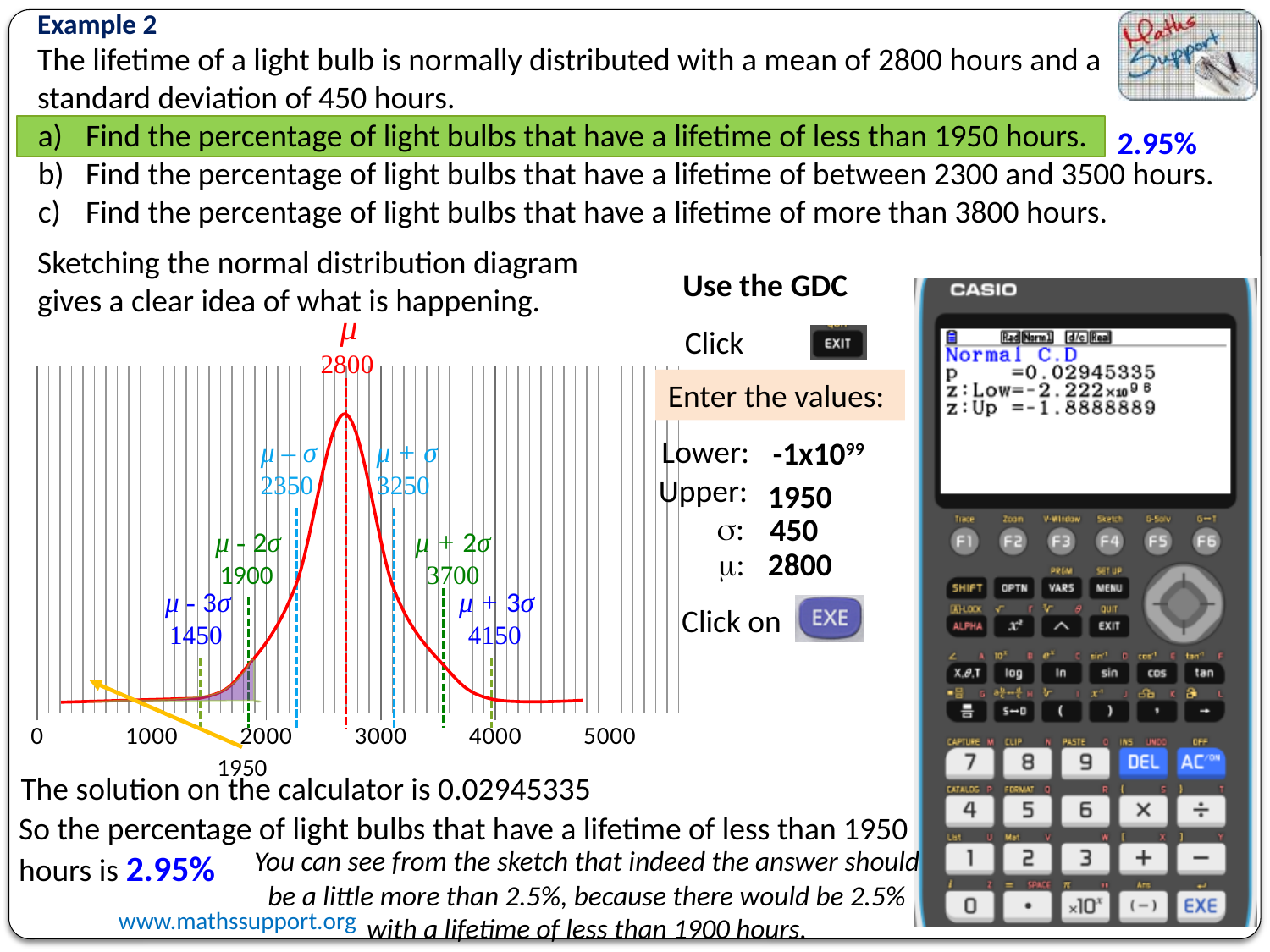
What value is labelled at μ − 2σ on the normal distribution sketch? 1900 What is the difference between the values labelled at μ + σ and μ − σ on the sketch? 900 What is the largest value printed on the x axis of the normal distribution sketch? 5000 What kind of chart is the normal distribution sketch? Line chart (bell curve) What colour is the normal distribution curve drawn in? Red What value is labelled at the mean μ on the normal distribution sketch? 2800 What value is labelled at μ − 3σ on the normal distribution sketch? 1450 What value is labelled at μ + 2σ on the normal distribution sketch? 3700 What value marks the right edge of the shaded region under the curve? 1950 What value is labelled at μ + σ on the normal distribution sketch? 3250 What value is labelled at μ − σ on the normal distribution sketch? 2350 What value is labelled at μ + 3σ on the normal distribution sketch? 4150